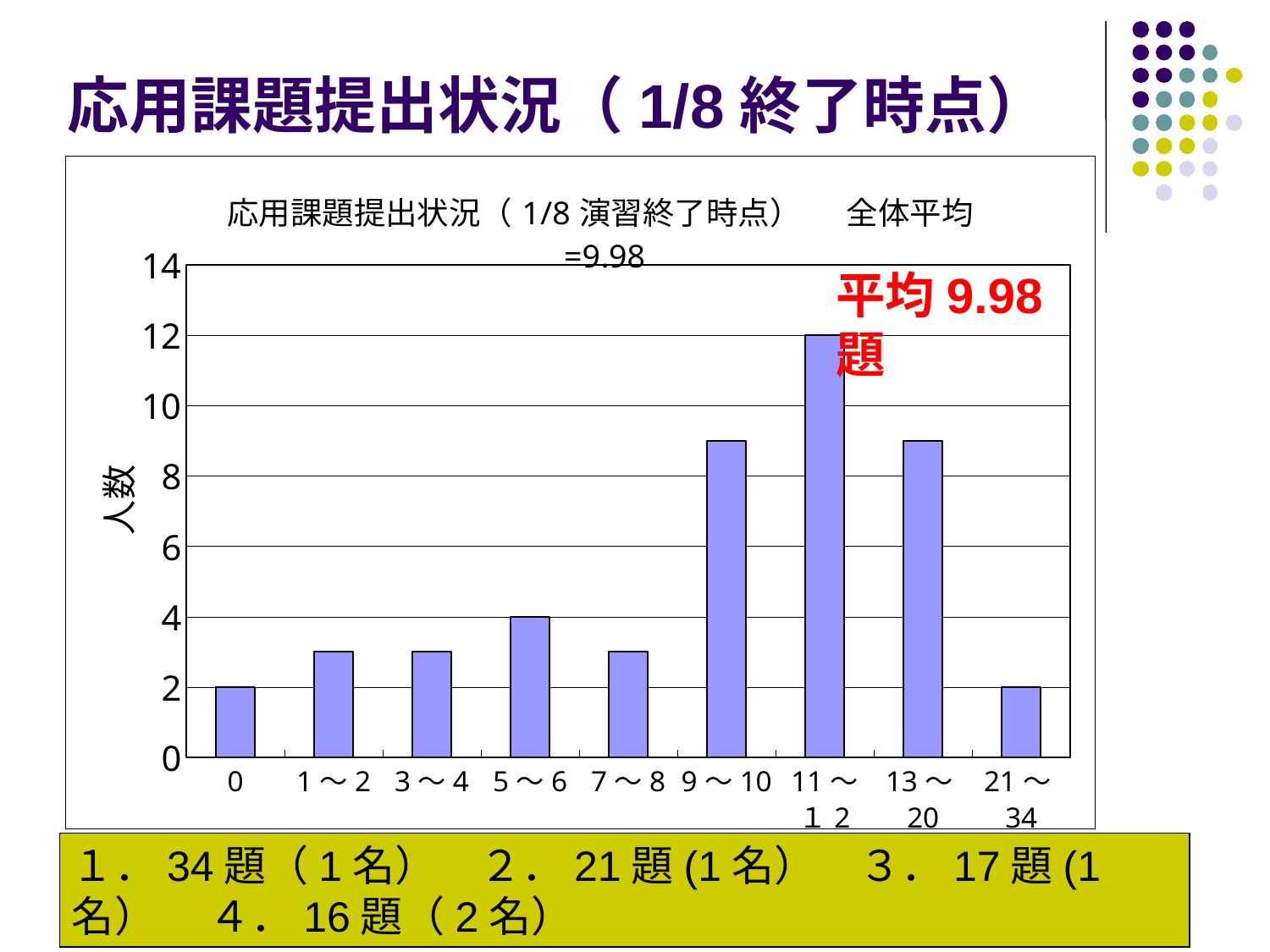
Which is larger, the value for 9～10 or the value for 11～12? 11～12 What is the value (人数) for the category 5～6? 4 What is the label of the y axis of the chart? 人数 Which category has the highest value in the chart? 11～12 What is the value (人数) for the category 11～12? 12 Is the value for 13～20 greater or less than 8? greater What is the value (人数) for the category 0? 2 What is the value (人数) for the category 21～34? 2 What kind of chart is shown on the slide? bar chart How many categories are shown on the x axis of the chart? 9 What is the difference between the values for 11～12 and 5～6? 8 Is the value for 9～10 greater or less than 10? less